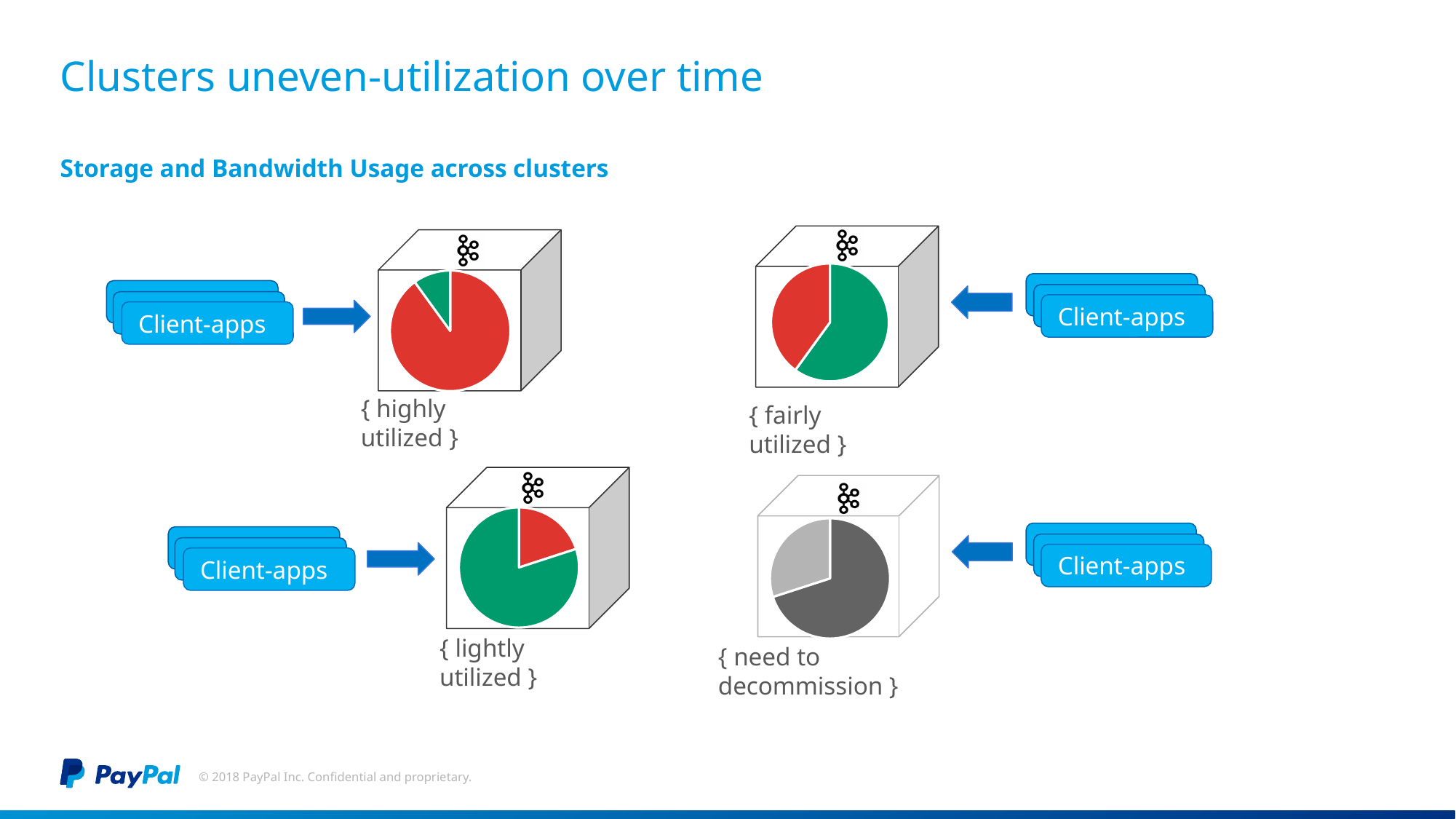
Which of the four pie charts has the largest red slice? { highly utilized } What is the subtitle above the pie charts on the slide? Storage and Bandwidth Usage across clusters What is the caption under the pie chart in the bottom-right of the slide? { need to decommission } Which of the four pie charts has the smallest red slice? { lightly utilized } In the pie chart labelled '{ highly utilized }', which slice is larger, the red one or the green one? red In the pie chart labelled '{ highly utilized }', how many slices are there? 2 In the pie chart labelled '{ need to decommission }', which slice is larger, the dark grey one or the light grey one? dark grey In the pie chart labelled '{ need to decommission }', how many slices are there? 2 In the pie chart labelled '{ fairly utilized }', which slice is larger, the red one or the green one? green What kind of chart is used for the cluster labelled '{ highly utilized }'? pie chart How many pie charts are shown on the slide? 4